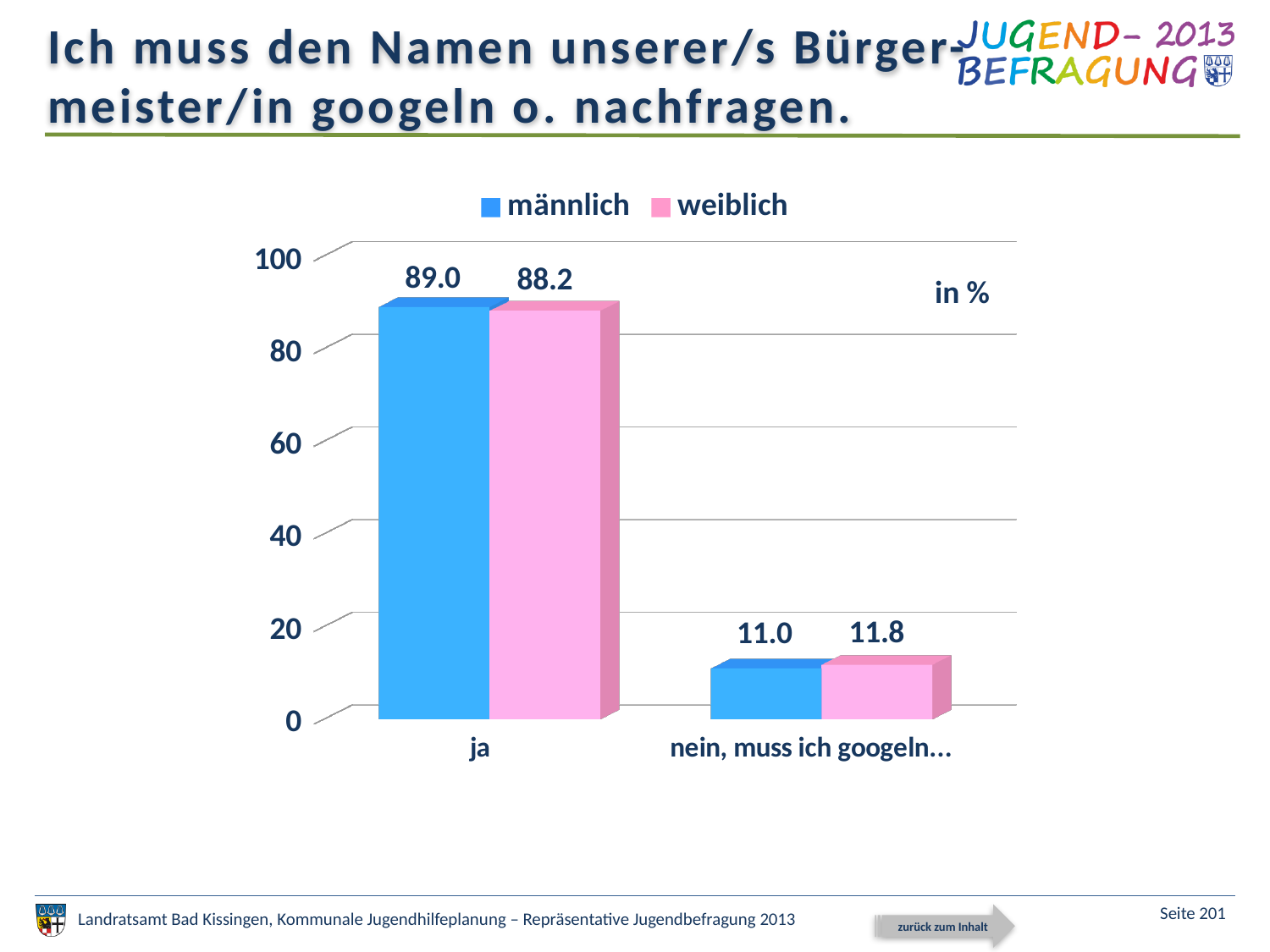
Which category has the highest value for männlich? ja How many categories are shown on the x axis? 2 What is the difference between the männlich and weiblich values in the category ja? 0.8 What is the value for männlich in the category ja? 89.0 Which category has the lowest value for weiblich? nein, muss ich googeln... What kind of chart is shown on the slide? bar chart Is the value for männlich in the category ja greater or less than 80? greater What is the value for weiblich in the category ja? 88.2 What is the difference between the männlich values for ja and nein, muss ich googeln...? 78.0 How many series does the legend list? 2 What is the value for weiblich in the category nein, muss ich googeln...? 11.8 What is the value for männlich in the category nein, muss ich googeln...? 11.0